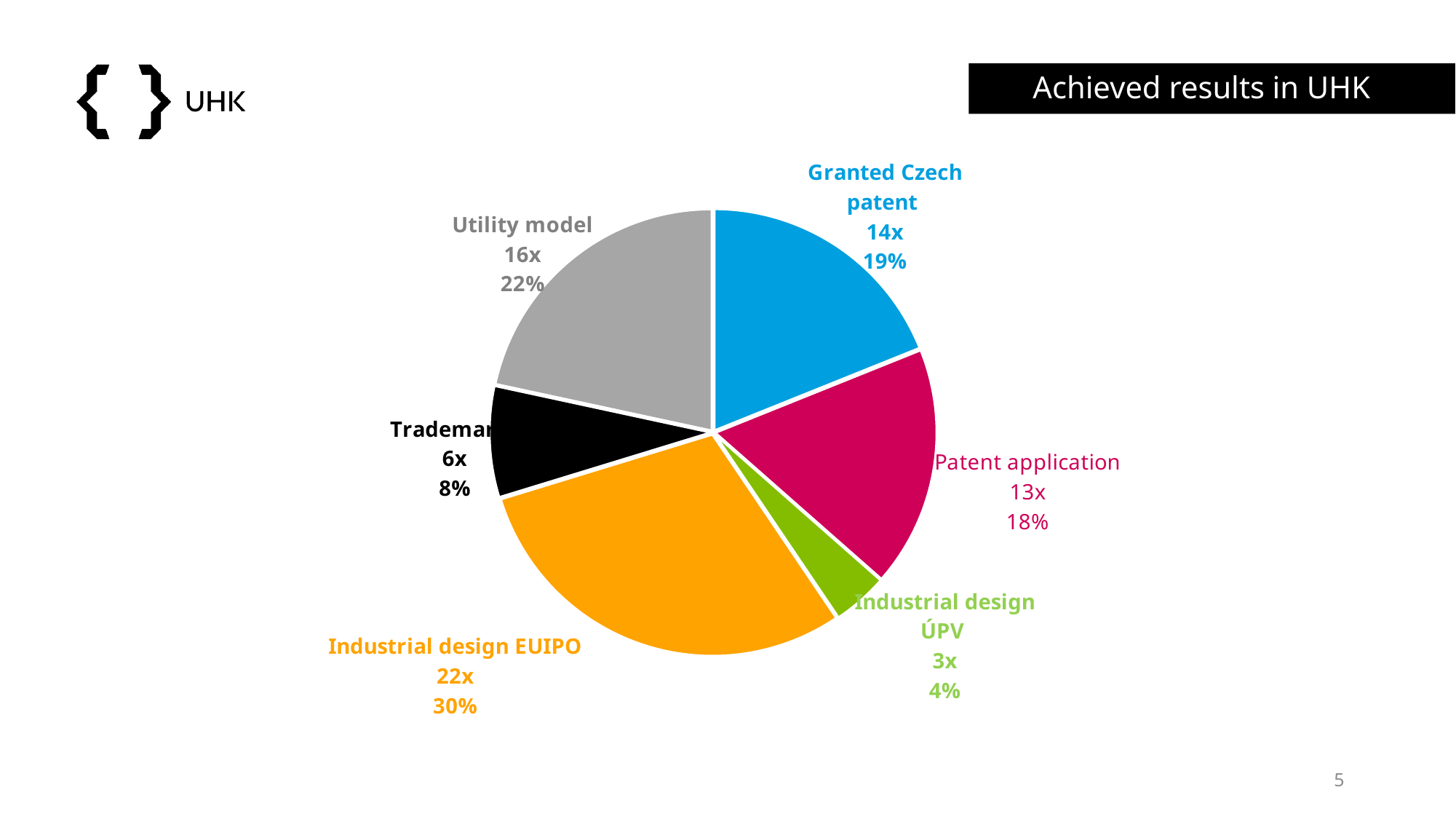
What kind of chart is shown on the slide? pie chart How many more Utility model results are there than Granted Czech patent results? 2 How many Industrial design EUIPO results are shown in the pie chart? 22x How many slices does the pie chart have? 6 Which category has the largest slice of the pie chart? Industrial design EUIPO What is the title shown on the slide? Achieved results in UHK Which category has the smallest slice of the pie chart? Industrial design ÚPV Which has more results, Granted Czech patent or Patent application? Granted Czech patent How many Patent application results are shown? 13x What share of the pie does Utility model account for? 22% What percentage of the pie does Granted Czech patent represent? 19% What is the difference in count between Industrial design EUIPO and Industrial design ÚPV? 19